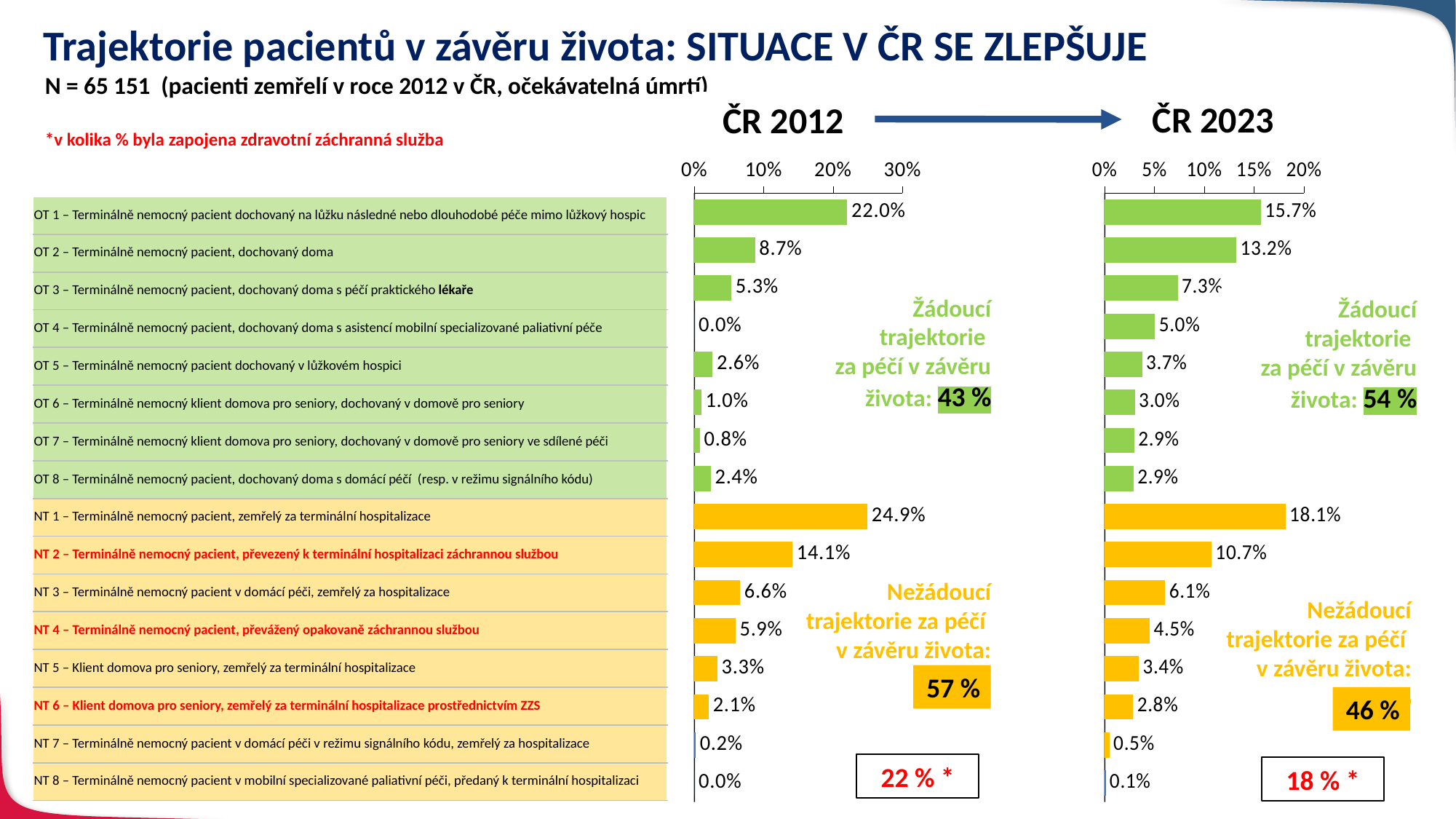
In the ČR 2012 chart, what is the difference between the values for OT 1 and OT 2? 13.3% What is the highest tick value shown on the x axis of the ČR 2023 chart? 20% In the ČR 2023 chart, what is the value for OT 2? 13.2% In the ČR 2023 chart, what is the value for NT 1? 18.1% In the ČR 2023 chart, which category has the lowest value? NT 8 In the ČR 2023 chart, is the value for OT 1 greater or less than 15%? greater What kind of chart is the ČR 2023 chart? bar chart In the ČR 2012 chart, which category has the highest value? NT 1 How many categories are plotted in the ČR 2012 chart? 16 In the ČR 2012 chart, what is the value for OT 1? 22.0% What is the difference between the NT 2 values in the ČR 2012 chart and the ČR 2023 chart? 3.4% In the ČR 2012 chart, which is larger, the value for OT 2 or the value for NT 3? OT 2